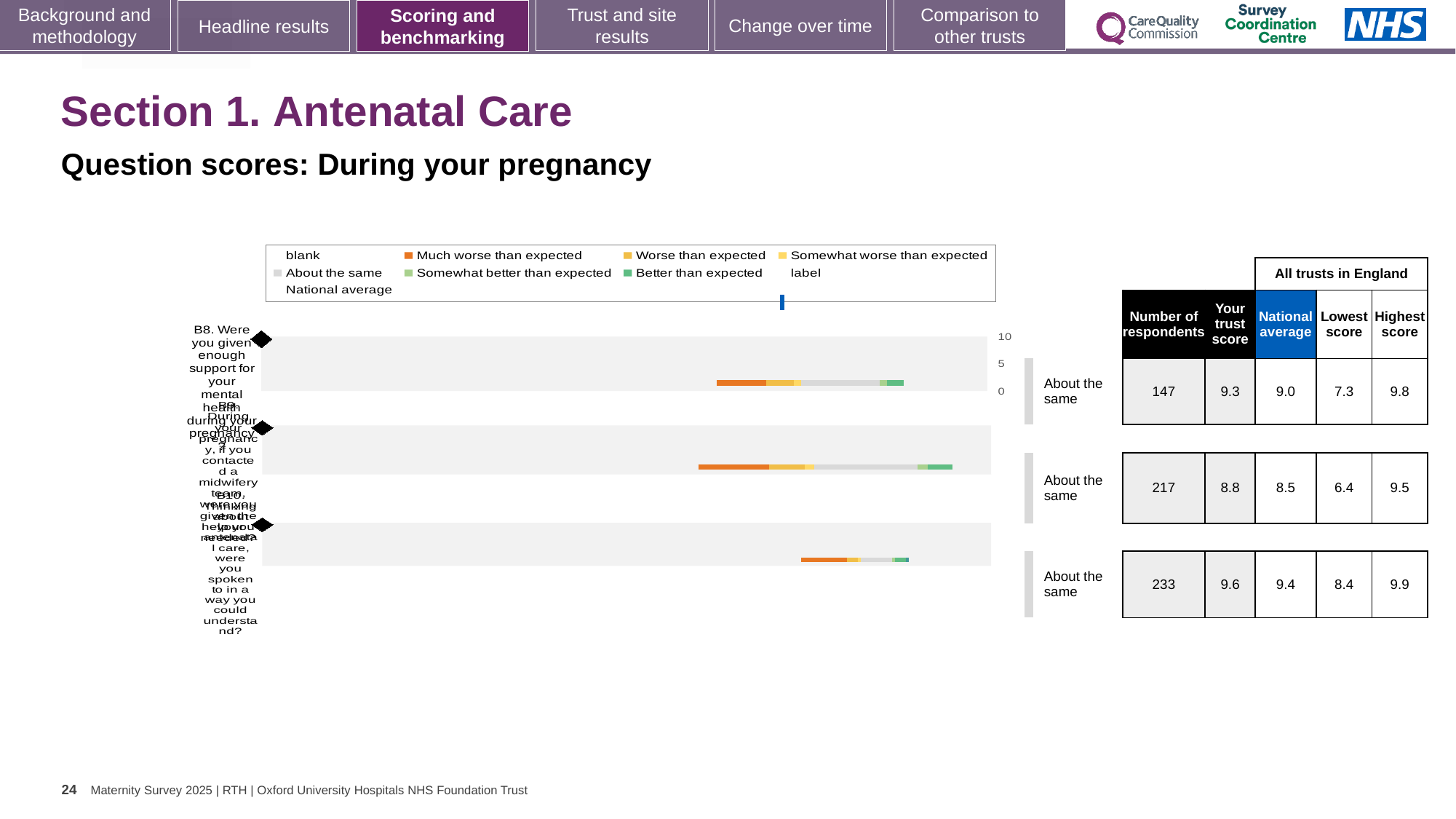
What is the trust score for question B8 (support for your mental health during pregnancy)? 9.3 What is the national average for the second (middle) question in the chart? 8.5 Which of the three questions has the lowest national average? the second (middle) question, 8.5 For question B8, what is the difference between the trust score and the national average? 0.3 What benchmark category is shown for all three questions in the chart? About the same What is the highest score among all trusts in England for the third (bottom) question in the chart? 9.9 Which of the three questions has the highest trust score? the third (bottom) question, 9.6 For the second (middle) question, what is the difference between the highest score and the lowest score among all trusts in England? 3.1 For the second (middle) question, which is larger: the trust score or the national average? the trust score (8.8) What kind of chart is used to show the question scores on this slide? bar chart How many respondents are listed for the first question, B8 (support for your mental health during pregnancy)? 147 How many questions (bars) are plotted in the chart? 3